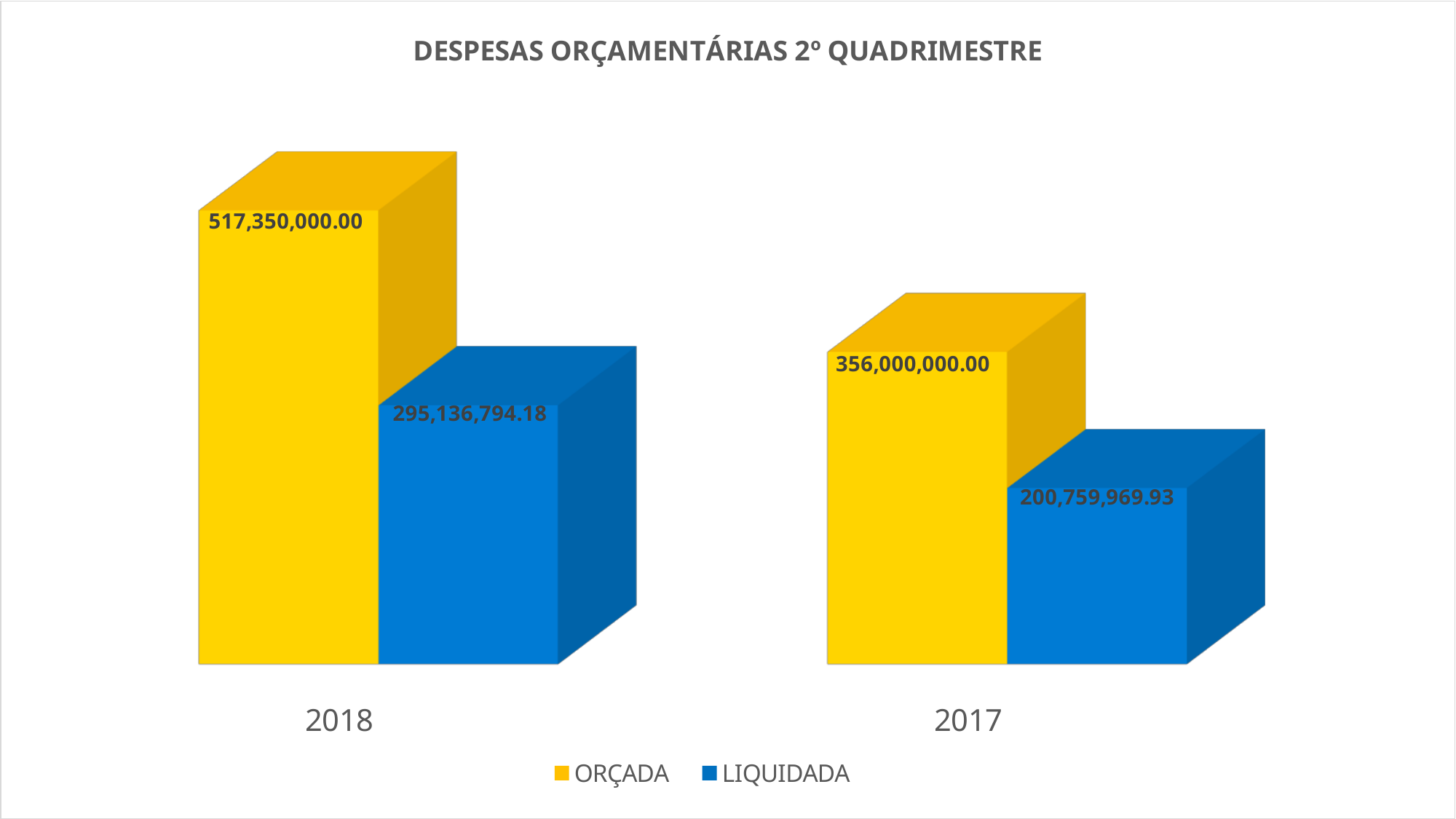
What kind of chart is shown on the slide? Bar chart How many series does the legend list? 2 What is the LIQUIDADA value for 2018? 295,136,794.18 What is the LIQUIDADA value for 2017? 200,759,969.93 What is the difference between the ORÇADA values for 2018 and 2017? 161,350,000.00 What is the difference between the ORÇADA and LIQUIDADA values for 2018? 222,213,205.82 Which year has the lowest LIQUIDADA value? 2017 Which year has the highest ORÇADA value? 2018 Which is larger, the LIQUIDADA value for 2018 or the ORÇADA value for 2017? ORÇADA value for 2017 What is the ORÇADA value for 2017? 356,000,000.00 How many categories are shown on the x axis? 2 What is the ORÇADA value for 2018? 517,350,000.00